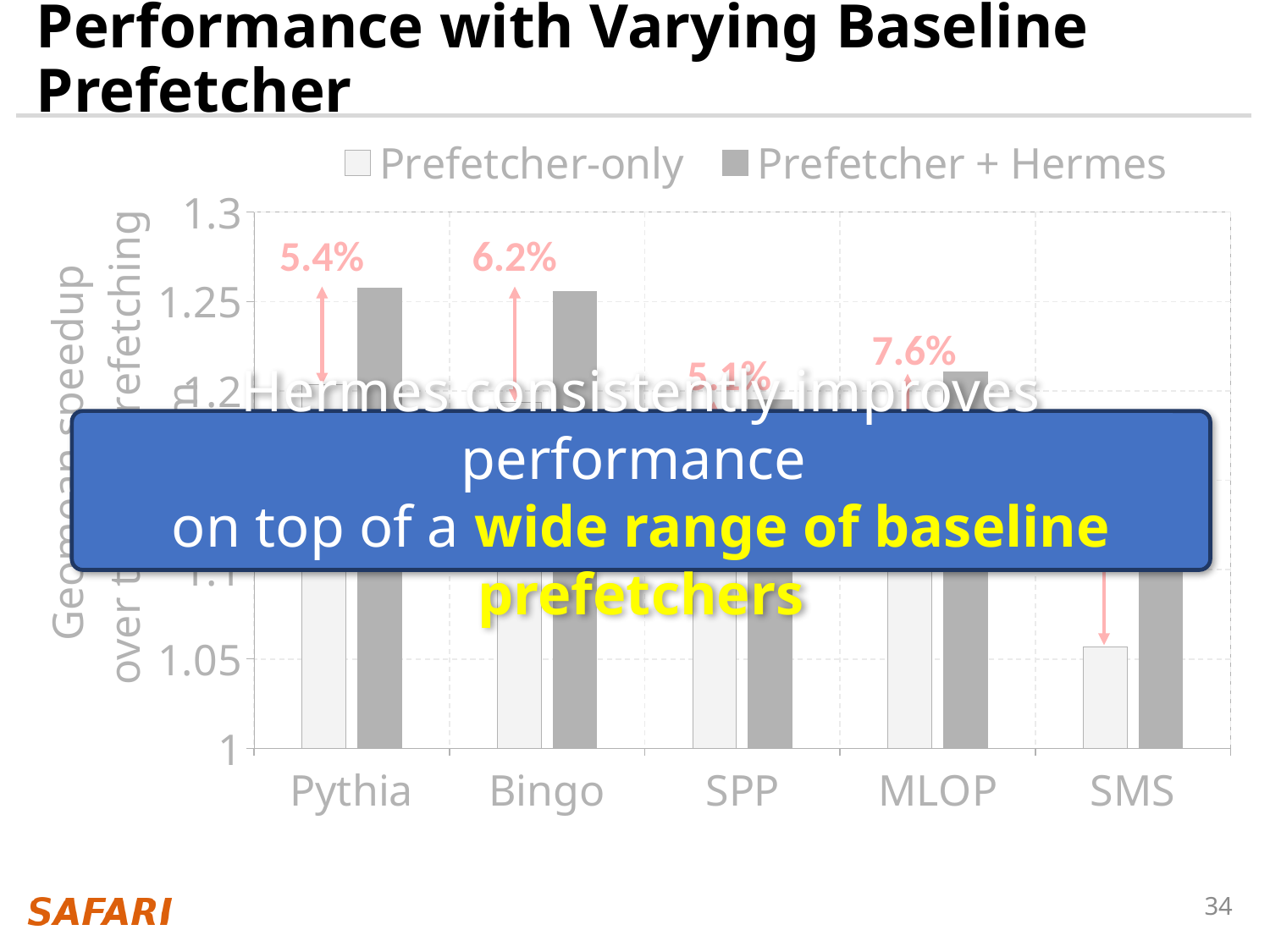
What are the two series named in the legend? Prefetcher-only and Prefetcher + Hermes How many series does the legend list? 2 Is the Prefetcher + Hermes value for Pythia greater or less than 1.25? greater Is the Prefetcher-only value for SMS greater or less than 1.1? less What kind of chart is shown on the slide? bar chart What is the difference between the labeled improvement for MLOP and the labeled improvement for Pythia? 2.2% What percentage improvement is labeled above the Bingo bars? 6.2% Which prefetcher has the smallest labeled percentage improvement? SPP Which prefetcher has the largest labeled percentage improvement? MLOP How many baseline prefetchers are shown on the x axis? 5 What percentage improvement is labeled above the MLOP bars? 7.6% What percentage improvement is labeled above the Pythia bars? 5.4%